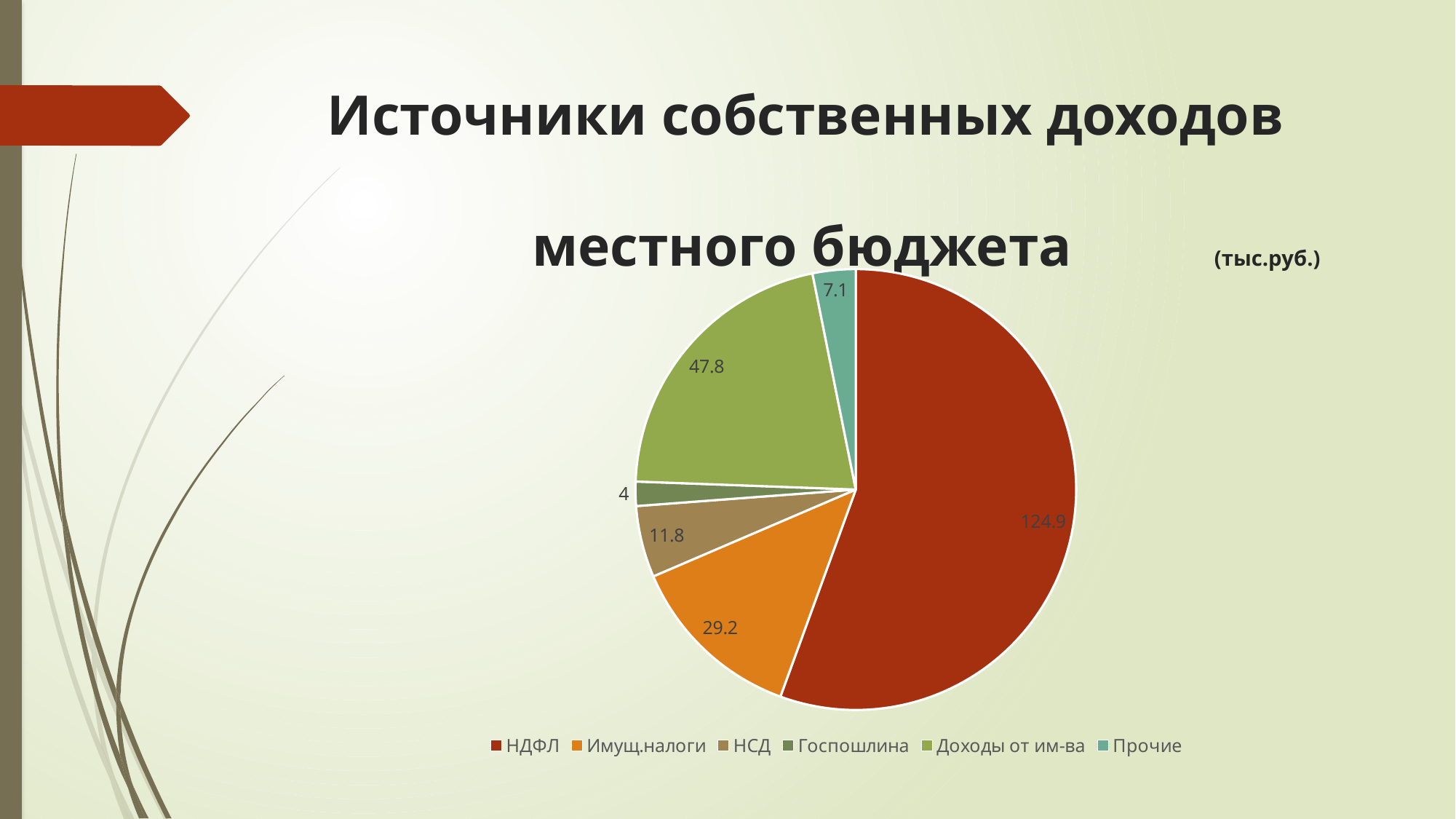
What unit is indicated next to the chart title? тыс.руб. What is the value for Доходы от им-ва? 47.8 What type of chart is shown on the slide? pie chart What is the value for Госпошлина? 4 Which source has the largest slice of the pie? НДФЛ Which is larger, Имущ.налоги or НСД? Имущ.налоги What is the difference between the values for НДФЛ and Доходы от им-ва? 77.1 Which source has the smallest slice of the pie? Госпошлина What is the value for НДФЛ in the pie chart? 124.9 What is the value for Имущ.налоги? 29.2 What is the total of all slices in the pie chart? 224.8 How many slices does the pie chart have? 6